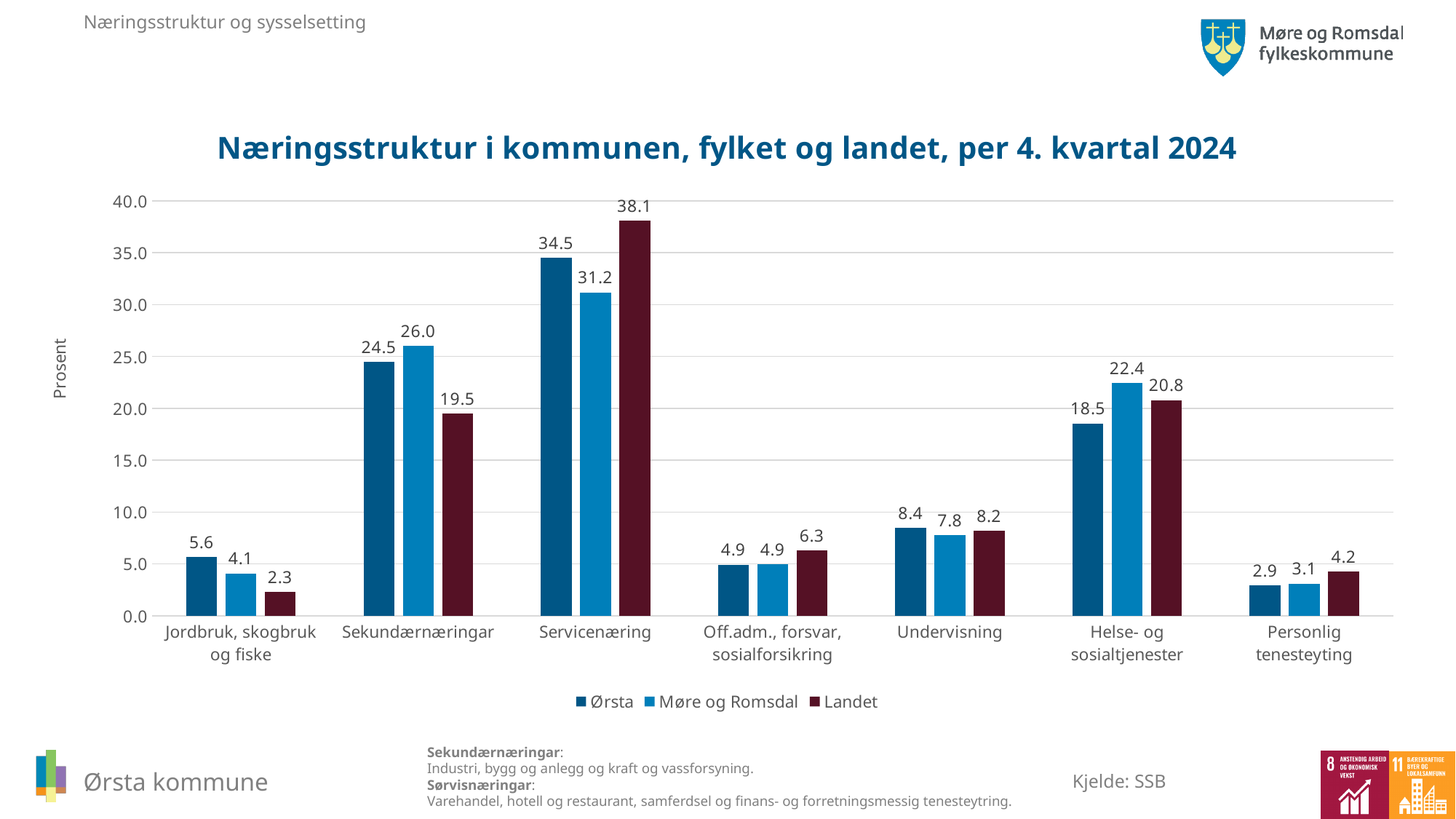
What kind of chart is shown on the slide? Bar chart What is the label of the y axis? Prosent What is the value for Landet in the Sekundærnæringar category? 19.5 How many categories are shown on the x axis? 7 What is the difference between the Landet and Ørsta values for Servicenæring? 3.6 Is the value for Møre og Romsdal in Sekundærnæringar greater or less than 25.0? greater What is the value for Ørsta in the Servicenæring category? 34.5 Which category has the lowest value for Ørsta? Personlig tenesteyting Which is larger in the Jordbruk, skogbruk og fiske category: the value for Ørsta or the value for Landet? Ørsta What is the value for Møre og Romsdal in the Helse- og sosialtjenester category? 22.4 Which category has the highest value for Landet? Servicenæring How many series does the legend list? 3